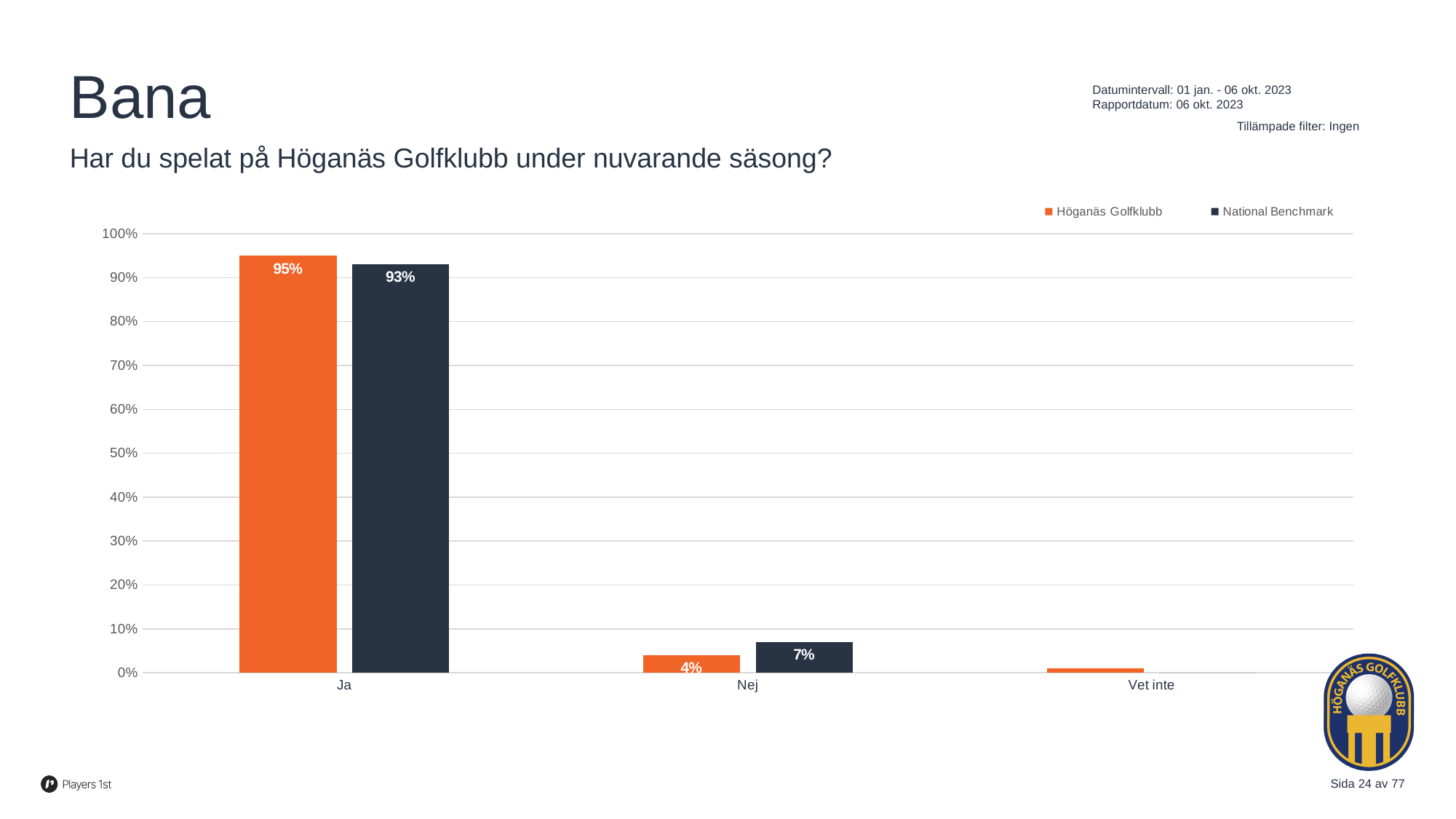
How many categories are shown on the x axis? 3 What kind of chart is shown on the slide? bar chart Which category has the lowest value for Höganäs Golfklubb? Vet inte How many series does the legend list? 2 What is the value for Höganäs Golfklubb for the category Ja? 95% Which category has the highest value for Höganäs Golfklubb? Ja What is the value for National Benchmark for the category Nej? 7% What is the value for National Benchmark for the category Ja? 93% For the category Ja, which series has the larger value, Höganäs Golfklubb or National Benchmark? Höganäs Golfklubb What is the value for Höganäs Golfklubb for the category Nej? 4% Is the value for Höganäs Golfklubb for Vet inte greater or less than 10%? less What is the difference between the Höganäs Golfklubb and National Benchmark values for Nej? 3%